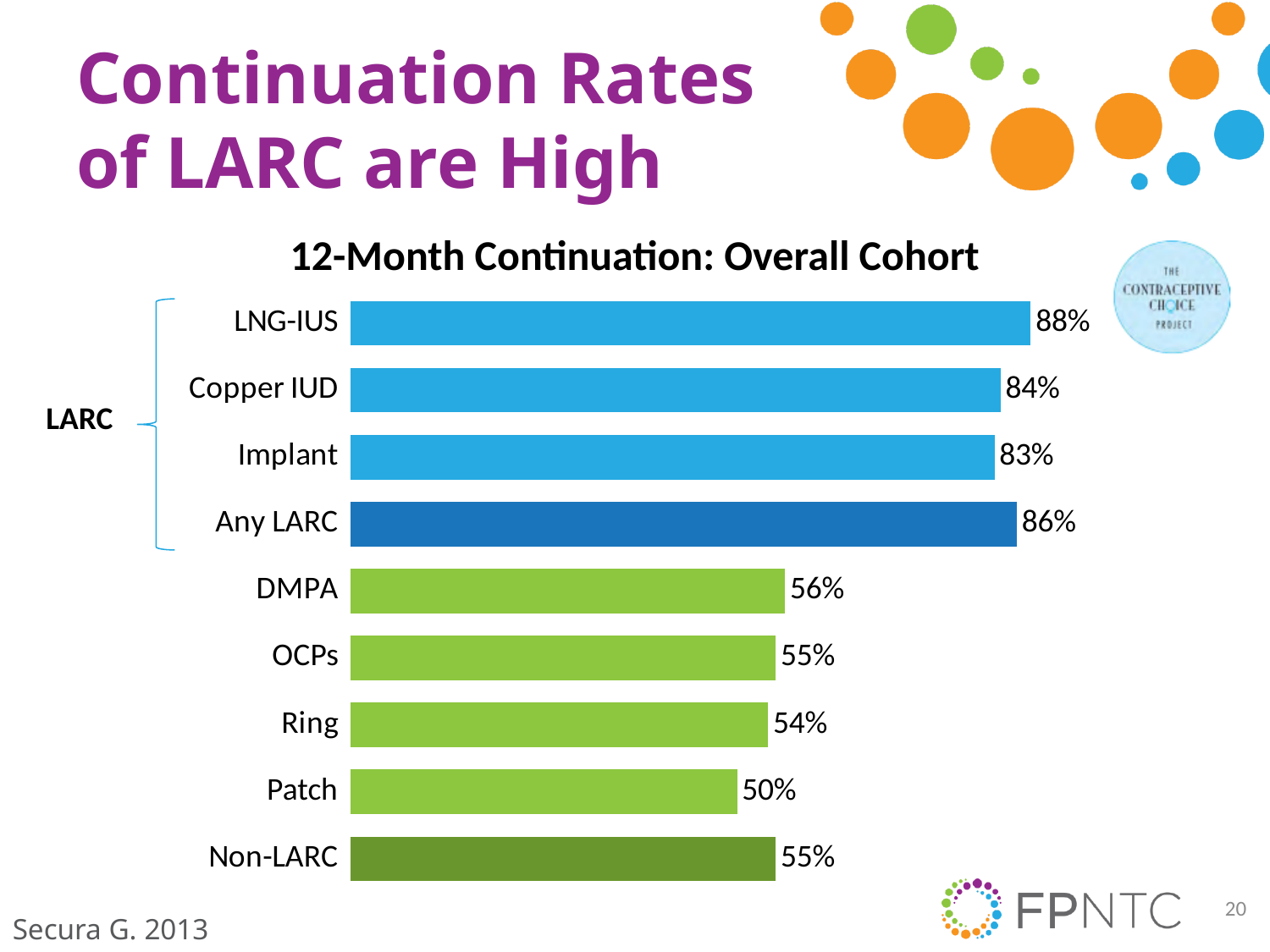
What is the 12-month continuation rate for Any LARC? 86% What is the 12-month continuation rate for LNG-IUS? 88% Which category has the lowest 12-month continuation rate? Patch Which categories are grouped under the LARC bracket? LNG-IUS, Copper IUD, Implant, Any LARC What kind of chart is shown on the slide? Bar chart How many categories are shown in the chart? 9 Which category has the highest 12-month continuation rate? LNG-IUS Which has a higher continuation rate, DMPA or Ring? DMPA What is the difference between the continuation rates for Copper IUD and Implant? 1% What is the 12-month continuation rate for Patch? 50% What is the title of the chart? 12-Month Continuation: Overall Cohort What is the difference between the continuation rates for Any LARC and Non-LARC? 31%